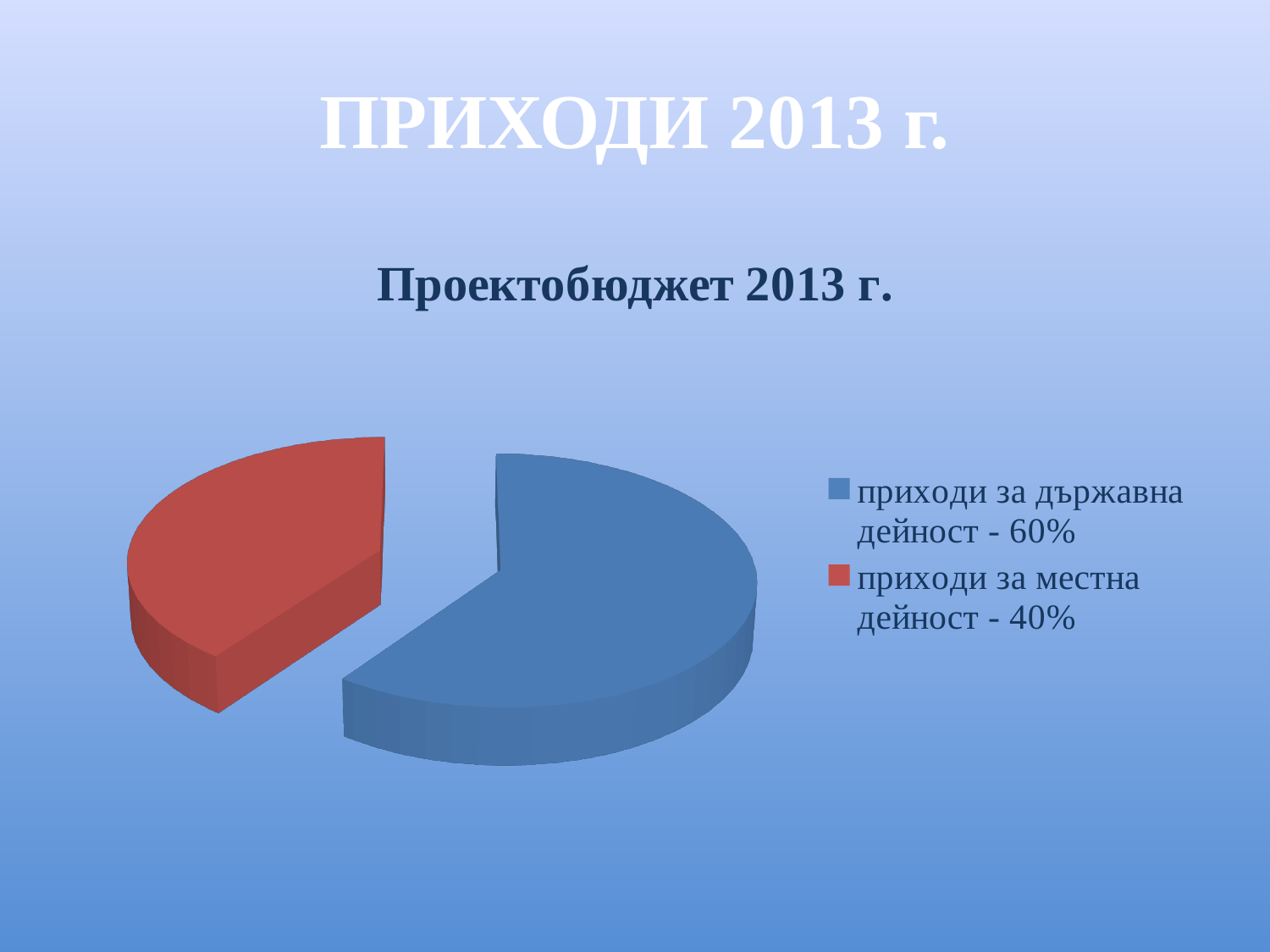
Which slice is the smallest? приходи за местна дейност What is the difference in percentage points between 'приходи за държавна дейност' and 'приходи за местна дейност'? 20% What is the title of the chart? Проектобюджет 2013 г. How many entries does the legend list? 2 What kind of chart is shown on the slide? pie chart What share of the pie is 'приходи за местна дейност'? 40% What colour is the slice for 'приходи за местна дейност'? red How many slices does the pie chart have? 2 What share of the pie is 'приходи за държавна дейност'? 60% Which is larger: 'приходи за държавна дейност' or 'приходи за местна дейност'? приходи за държавна дейност Which slice is the largest? приходи за държавна дейност